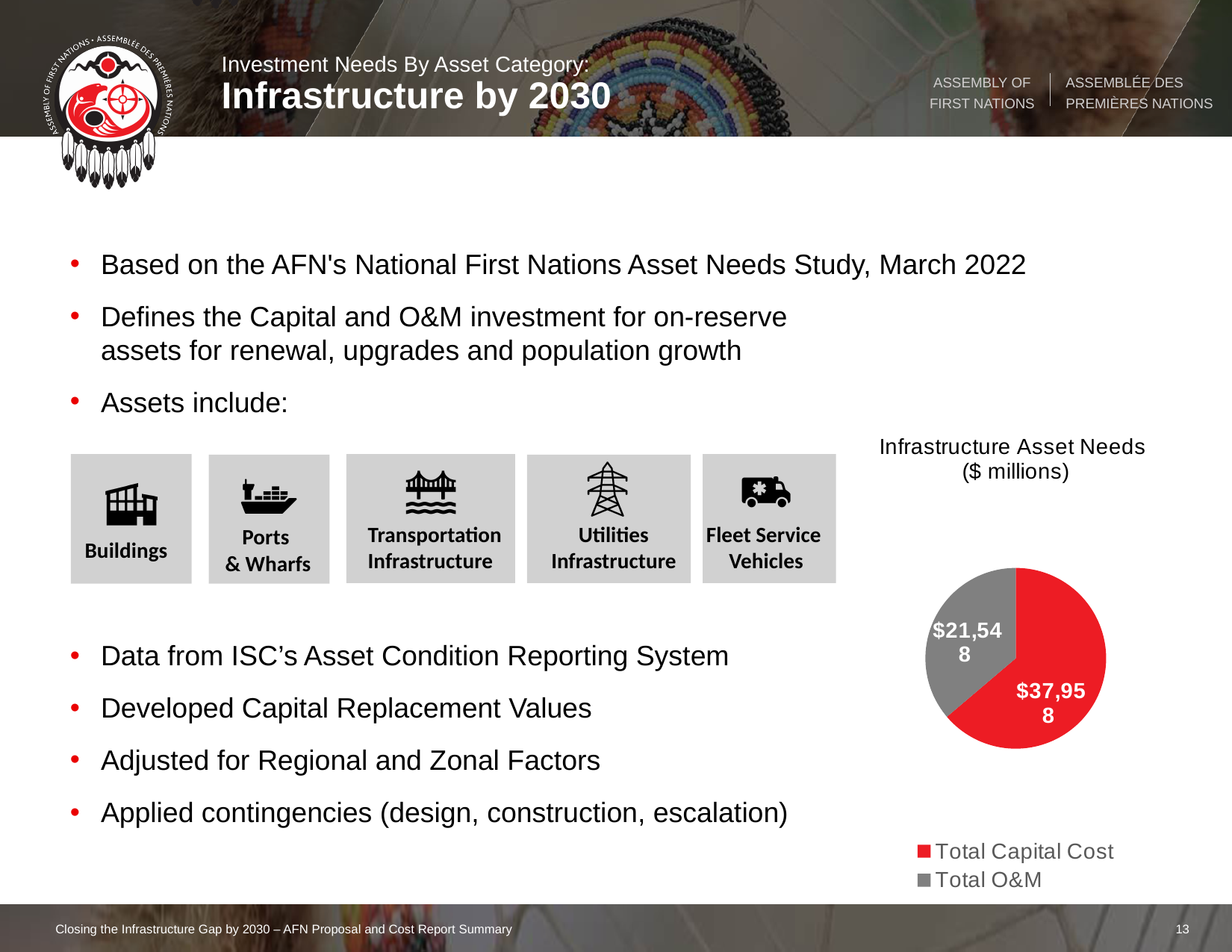
What kind of chart is shown on the slide? Pie chart What is the value for Total O&M in the pie chart? $21,548 How many slices does the pie chart have? 2 What is the combined total of the two slices in the pie chart? $59,506 Which slice of the pie chart is the smallest? Total O&M Which is larger, Total Capital Cost or Total O&M? Total Capital Cost What colour is the Total O&M slice in the pie chart? Grey How many entries does the legend list? 2 What is the title of the chart? Infrastructure Asset Needs ($ millions) Which slice of the pie chart is the largest? Total Capital Cost What is the value for Total Capital Cost in the pie chart? $37,958 What is the difference between Total Capital Cost and Total O&M? $16,410